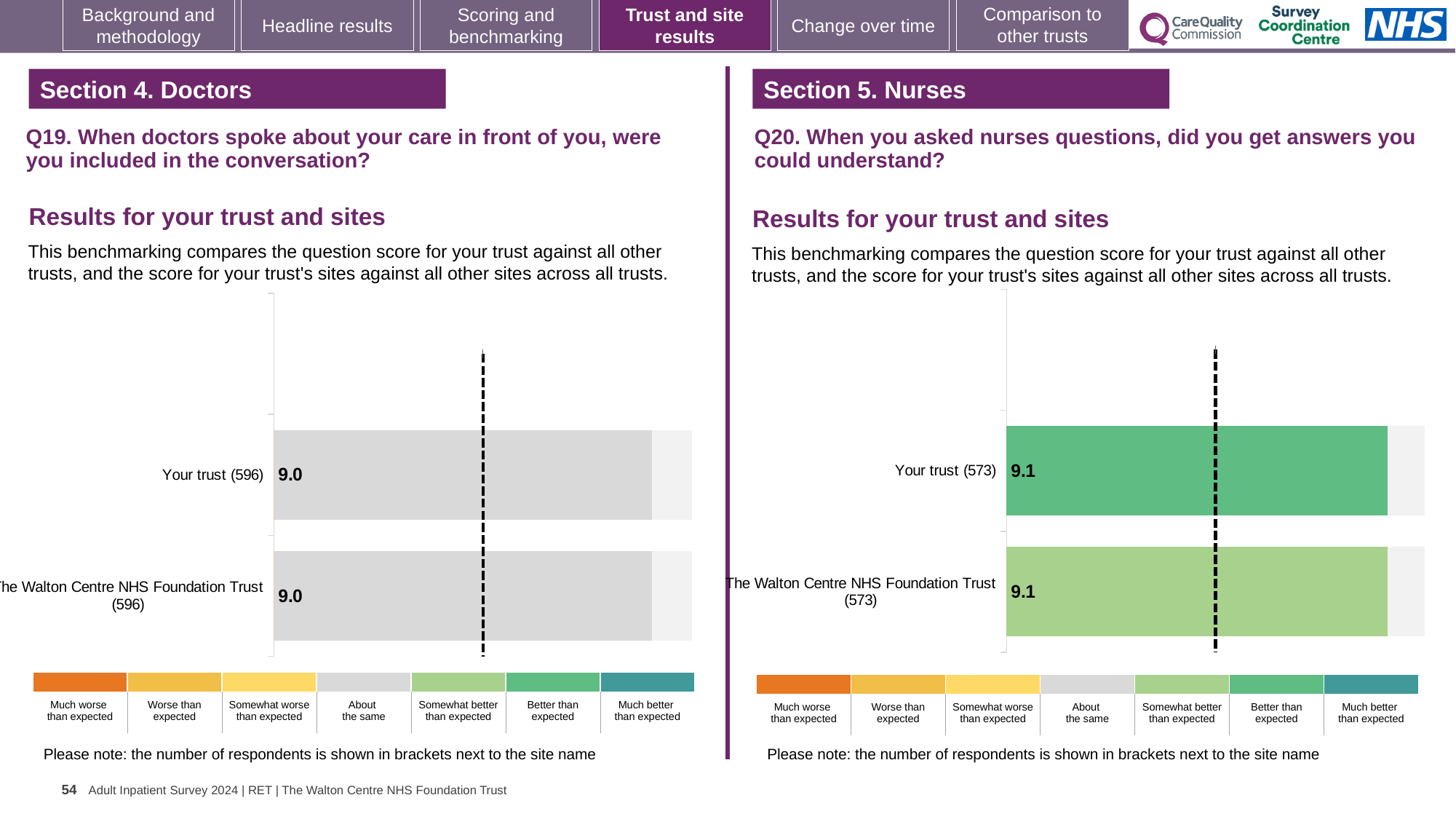
On the Q20 chart (Section 5. Nurses), how many bars are plotted? 2 On the Q20 chart (Section 5. Nurses), what is the score for The Walton Centre NHS Foundation Trust? 9.1 On the Q20 chart (Section 5. Nurses), which benchmark category does the colour of the Your trust bar correspond to in the key? Better than expected On the Q19 chart (Section 4. Doctors), what is the score for The Walton Centre NHS Foundation Trust? 9.0 On the Q20 chart (Section 5. Nurses), how many respondents are shown in brackets for The Walton Centre NHS Foundation Trust? 573 What type of chart is used on the Q20 chart (Section 5. Nurses)? Bar chart On the Q19 chart (Section 4. Doctors), how many respondents are shown in brackets for Your trust? 596 On the Q19 chart (Section 4. Doctors), what is the score for Your trust? 9.0 On the Q19 chart (Section 4. Doctors), what is the difference between the score for Your trust and the score for The Walton Centre NHS Foundation Trust? 0.0 On the Q20 chart (Section 5. Nurses), what is the score for Your trust? 9.1 On the Q19 chart (Section 4. Doctors), which benchmark category does the grey colour of the bars correspond to in the key? About the same On the Q19 chart (Section 4. Doctors), how many bars are plotted? 2